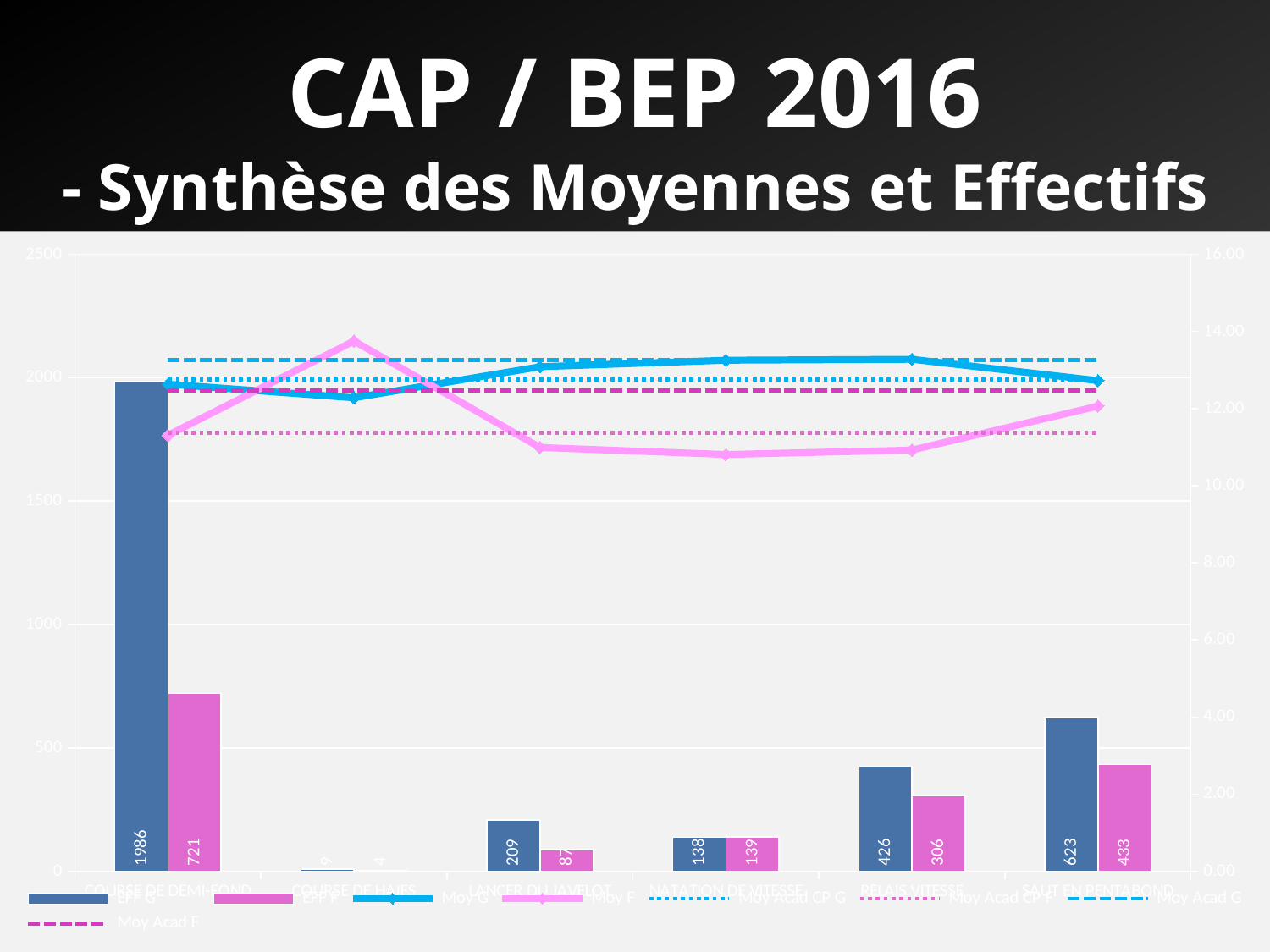
How many series does the legend list? 8 How many categories are shown on the x axis? 6 Is the Moy F value for NATATION DE VITESSE greater or less than 12.00 on the right axis? less Which category has the highest EFF G value? COURSE DE DEMI-FOND What is the EFF F value for LANCER DU JAVELOT? 87 Which is larger for SAUT EN PENTABOND, EFF G or EFF F? EFF G What is the EFF F value for SAUT EN PENTABOND? 433 What is the EFF G value for COURSE DE DEMI-FOND? 1986 What is the EFF G value for RELAIS VITESSE? 426 What is the difference between the EFF G and EFF F values for COURSE DE DEMI-FOND? 1265 Which category has the lowest EFF F value? COURSE DE HAIES What kind of chart is shown on the slide? Combination bar and line chart